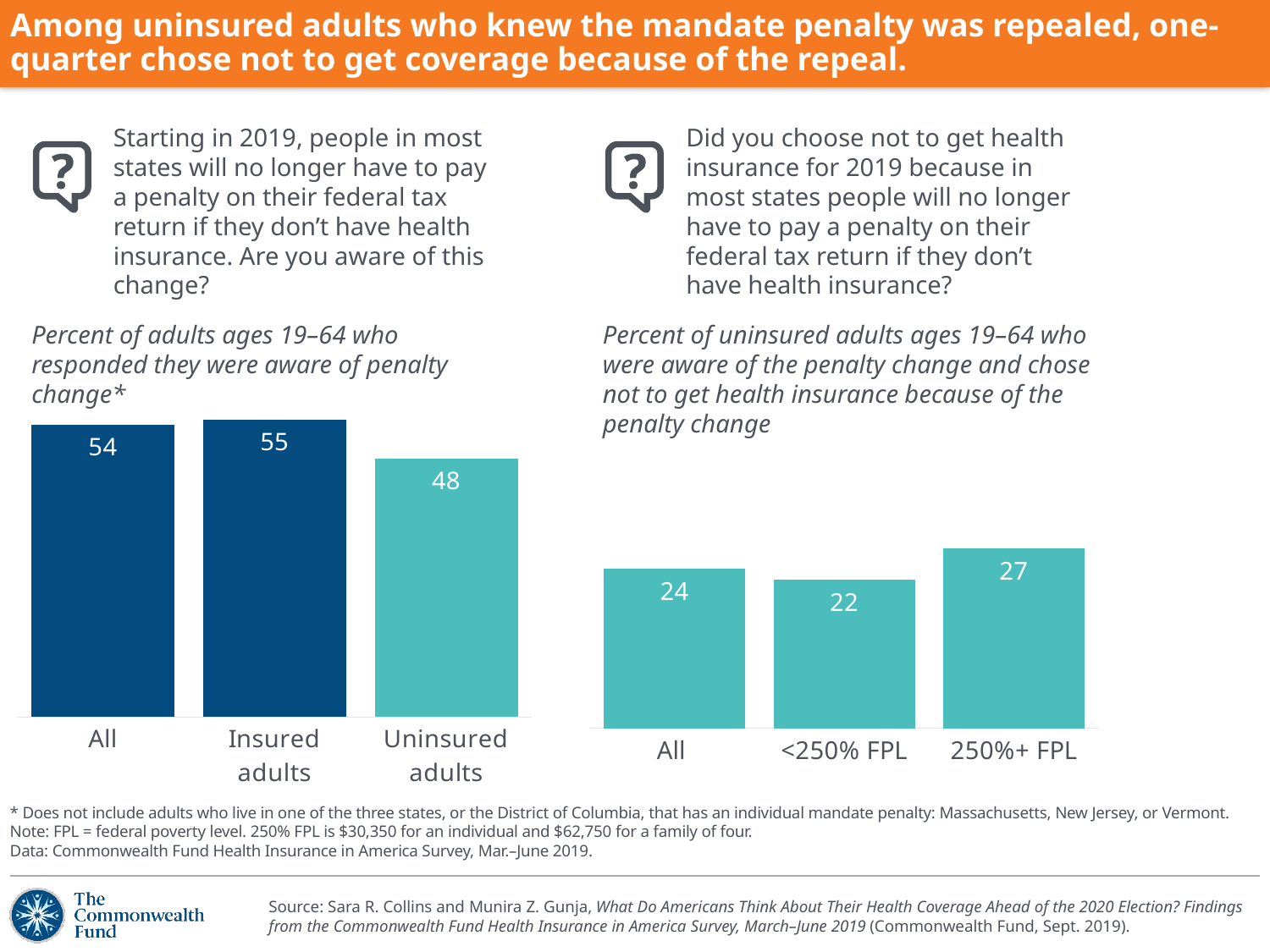
In the right chart (uninsured adults who chose not to get insurance because of the penalty change), which category has the highest value? 250%+ FPL In the left chart (percent of adults aware of penalty change), what is the value for Insured adults? 55 In the right chart (uninsured adults who chose not to get insurance because of the penalty change), which is larger, the value for All or the value for <250% FPL? All In the left chart (percent of adults aware of penalty change), what is the value for Uninsured adults? 48 In the right chart (uninsured adults who chose not to get insurance because of the penalty change), what is the value for <250% FPL? 22 In the left chart (percent of adults aware of penalty change), which category has the lowest value? Uninsured adults In the left chart (percent of adults aware of penalty change), which category's bar is shown in a lighter teal colour than the others? Uninsured adults In the left chart (percent of adults aware of penalty change), how many categories are shown? 3 In the right chart (uninsured adults who chose not to get insurance because of the penalty change), what is the difference between the values for 250%+ FPL and <250% FPL? 5 What kind of chart is the left chart (percent of adults aware of penalty change)? Bar chart In the left chart (percent of adults aware of penalty change), what is the difference between the values for Insured adults and Uninsured adults? 7 In the right chart (uninsured adults who chose not to get insurance because of the penalty change), what is the value for All? 24